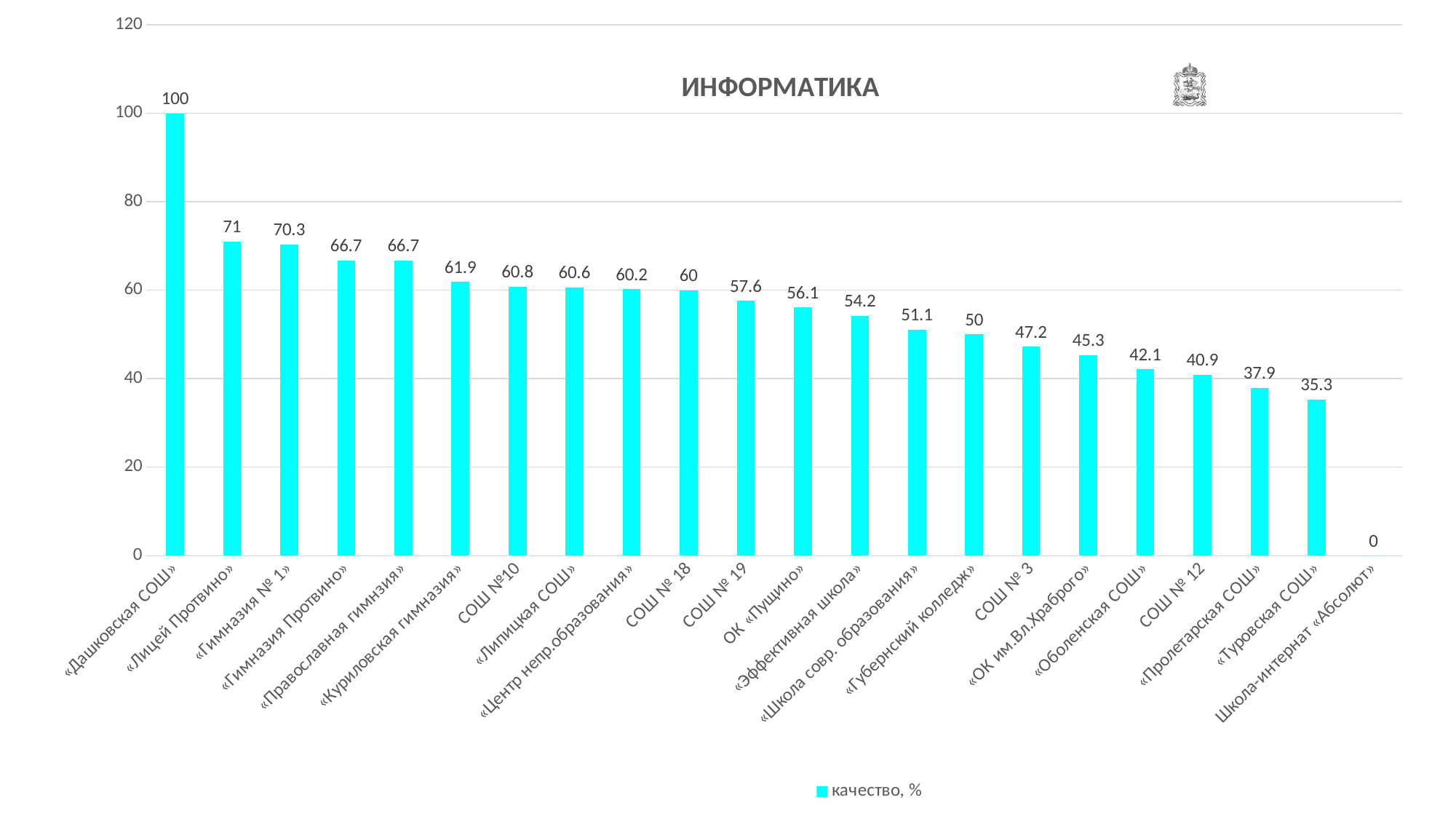
Which category has the lowest value? Школа-интернат «Абсолют» Is the value for «Пролетарская СОШ» greater or less than 40? less What is the value for «Туровская СОШ»? 35.3 What is the title of the chart? ИНФОРМАТИКА What is the value for «Губернский колледж»? 50 What is the value for «Лицей Протвино»? 71 What is the difference between the values for «Дашковская СОШ» and «Лицей Протвино»? 29 What kind of chart is shown on the slide? bar chart What is the difference between the values for «Оболенская СОШ» and «СОШ № 12»? 1.2 Which category has the highest value? «Дашковская СОШ» How many categories are shown on the chart? 22 Which is larger, the value for «Куриловская гимназия» or the value for «СОШ № 3»? «Куриловская гимназия»